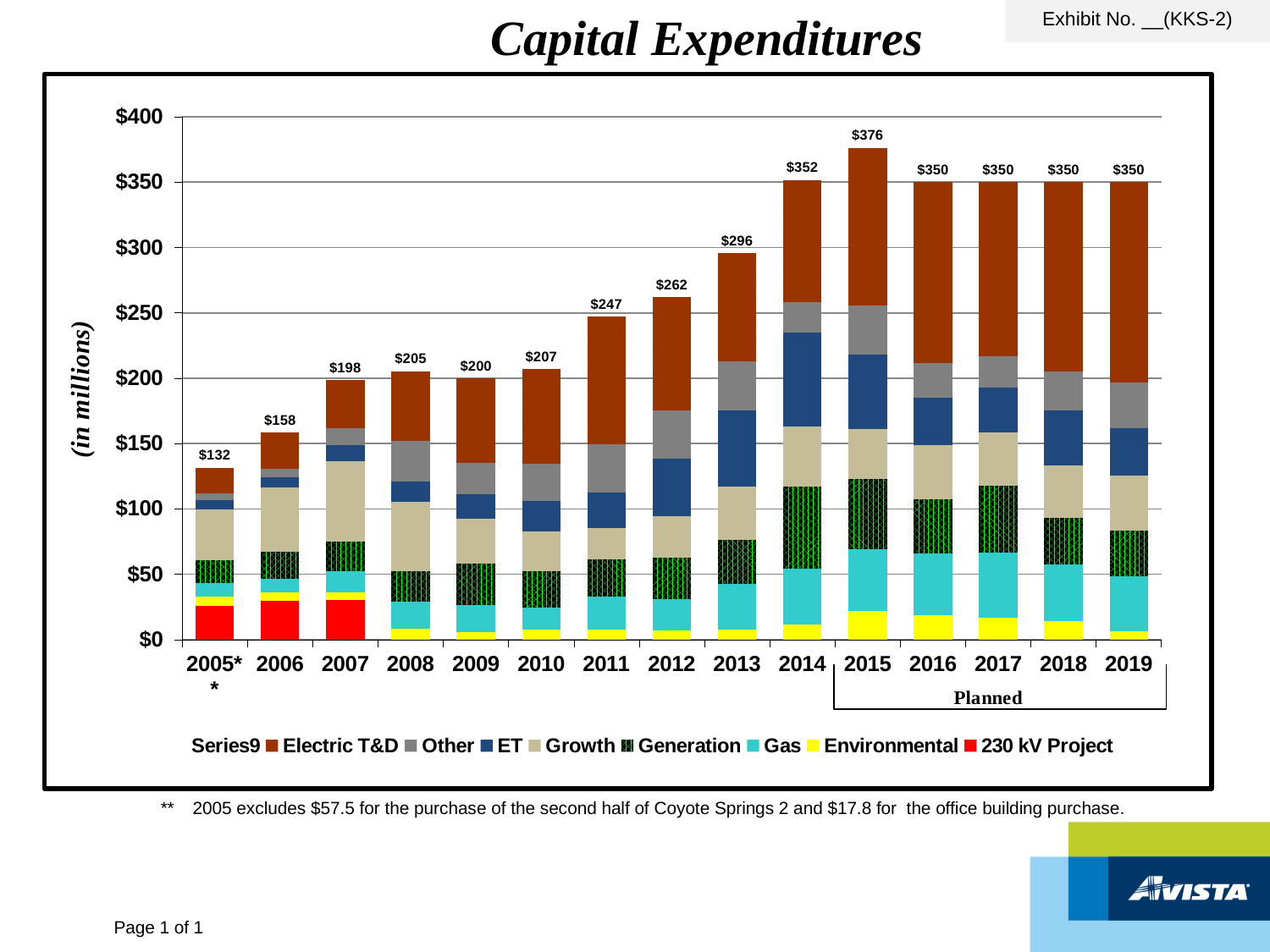
What is the total capital expenditure shown for 2005*? $132 Which year has the lowest total capital expenditure? 2005* What is the total capital expenditure shown for 2015? $376 What is the difference between the total for 2013 and the total for 2012? $34 How many years are shown on the x axis? 15 Do the total capital expenditures rise or fall from 2005* to 2015? Rise What is the difference between the total for 2015 and the total for 2014? $24 What kind of chart is shown on the slide? Stacked bar chart How many series does the legend list? 9 Which year has the highest total capital expenditure? 2015 What is the total capital expenditure shown for 2011? $247 Which year has a larger total, 2008 or 2009? 2008